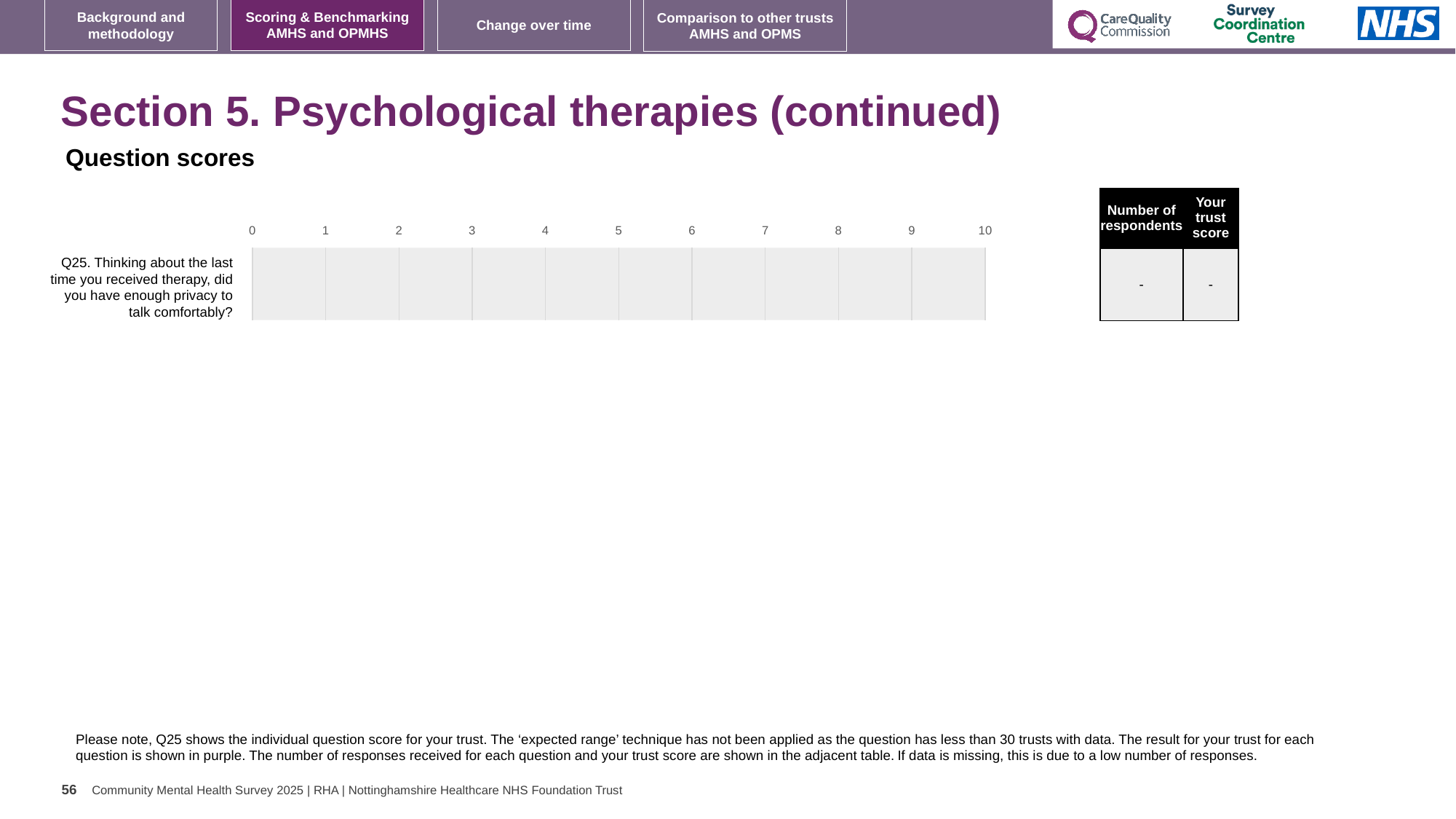
What is shown in the 'Your trust score' column of the table for Q25? - What is the highest value shown on the chart's horizontal axis? 10 What kind of chart is shown on the slide? bar chart What is shown in the 'Number of respondents' column of the table for Q25? - Is a bar plotted for Q25 on the chart? No How many questions (categories) are listed on the chart? 1